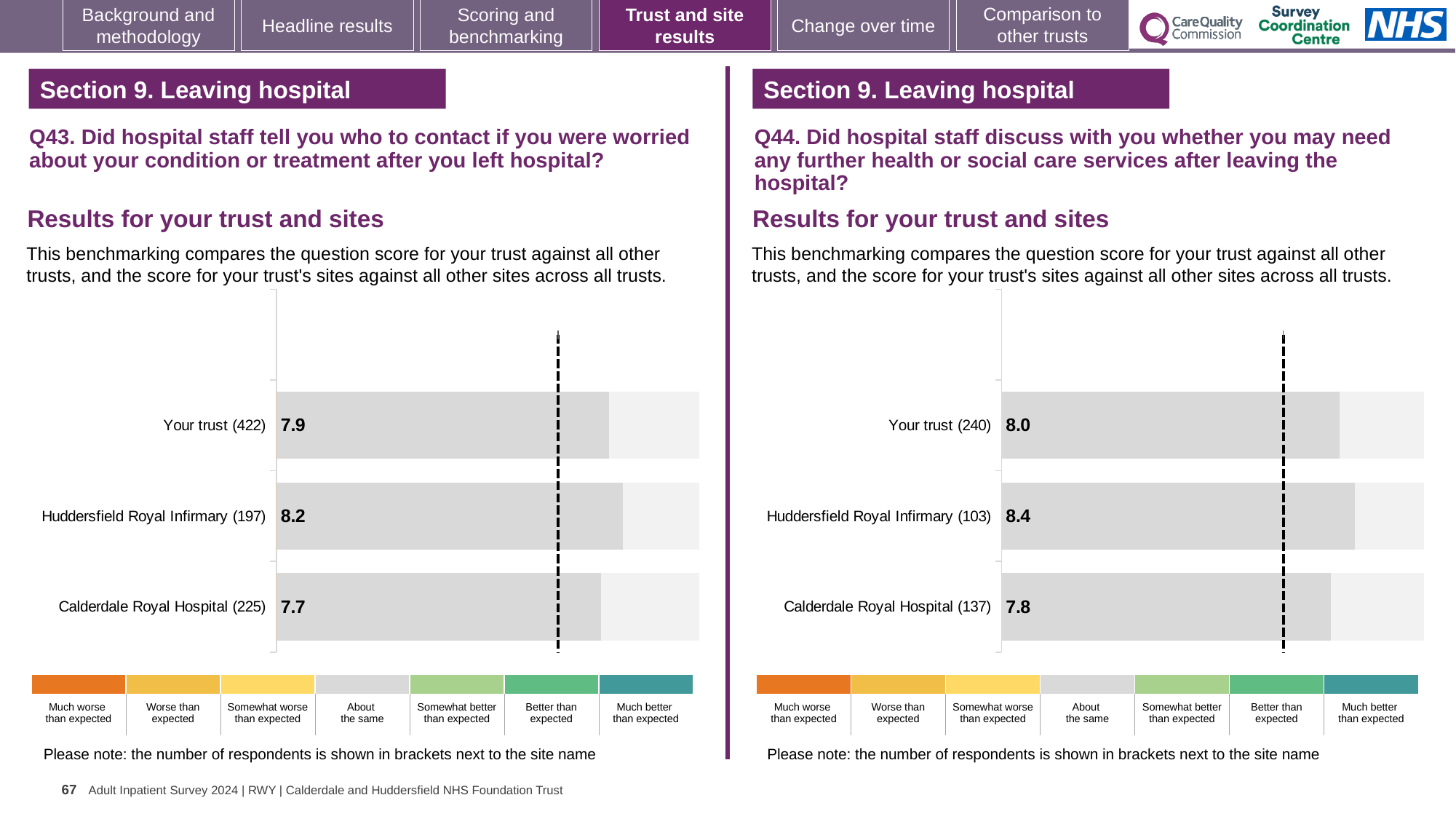
In the Q43 chart on the left, what is the score for Your trust (422)? 7.9 How many bars are plotted in the Q43 chart on the left? 3 In the Q44 chart on the right, what is the score for Calderdale Royal Hospital (137)? 7.8 In the Q44 chart on the right, what is the difference between the scores for Huddersfield Royal Infirmary and Your trust? 0.4 In the Q44 chart on the right, what is the score for Your trust (240)? 8.0 What kind of chart is used for the Q44 results on the right? Bar chart In the Q43 chart on the left, how many respondents are shown in brackets for Calderdale Royal Hospital? 225 In the Q44 chart on the right, which has the larger score: Your trust or Calderdale Royal Hospital? Your trust In the Q43 chart on the left, which site or trust has the lowest score? Calderdale Royal Hospital (225) In the Q43 chart on the left, what is the score for Huddersfield Royal Infirmary (197)? 8.2 In the Q43 chart on the left, what is the difference between the scores for Huddersfield Royal Infirmary and Calderdale Royal Hospital? 0.5 In the Q44 chart on the right, which site or trust has the highest score? Huddersfield Royal Infirmary (103)